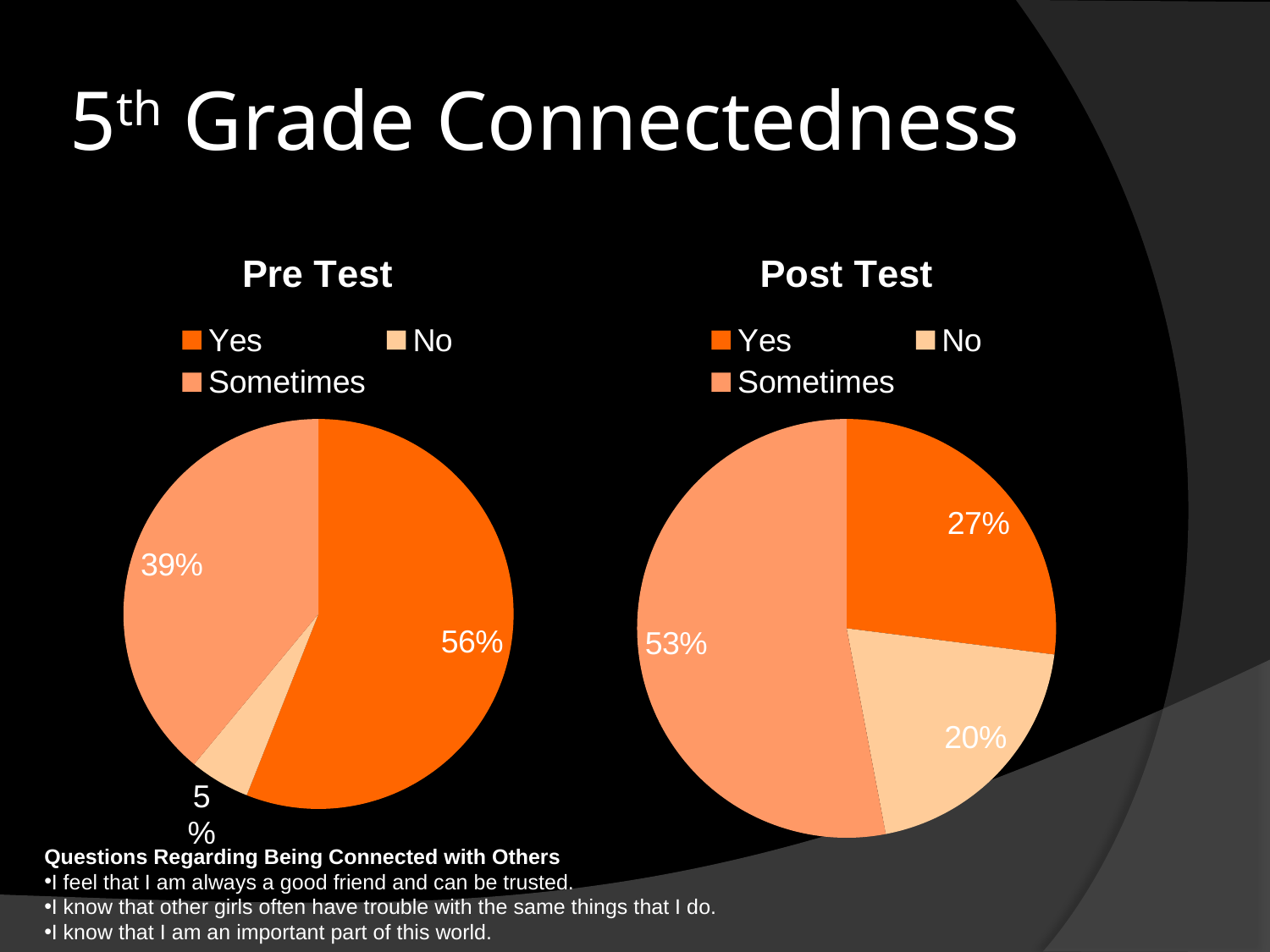
In the Post Test chart, what percentage is shown for Yes? 27% In the Pre Test chart, what percentage is shown for No? 5% In the Pre Test chart, which category has the largest slice? Yes In the Post Test chart, what percentage is shown for Sometimes? 53% What is the difference between the Yes percentage in the Pre Test chart and the Yes percentage in the Post Test chart? 29% In the Post Test chart, what percentage is shown for No? 20% In the Post Test chart, which category has the smallest slice? No In the Pre Test chart, what percentage is shown for Yes? 56% In the Pre Test chart, what percentage is shown for Sometimes? 39% What type of chart is the Post Test chart? Pie chart Which is larger: Sometimes in the Pre Test chart or Sometimes in the Post Test chart? Post Test How many categories does the legend of the Pre Test chart list? 3